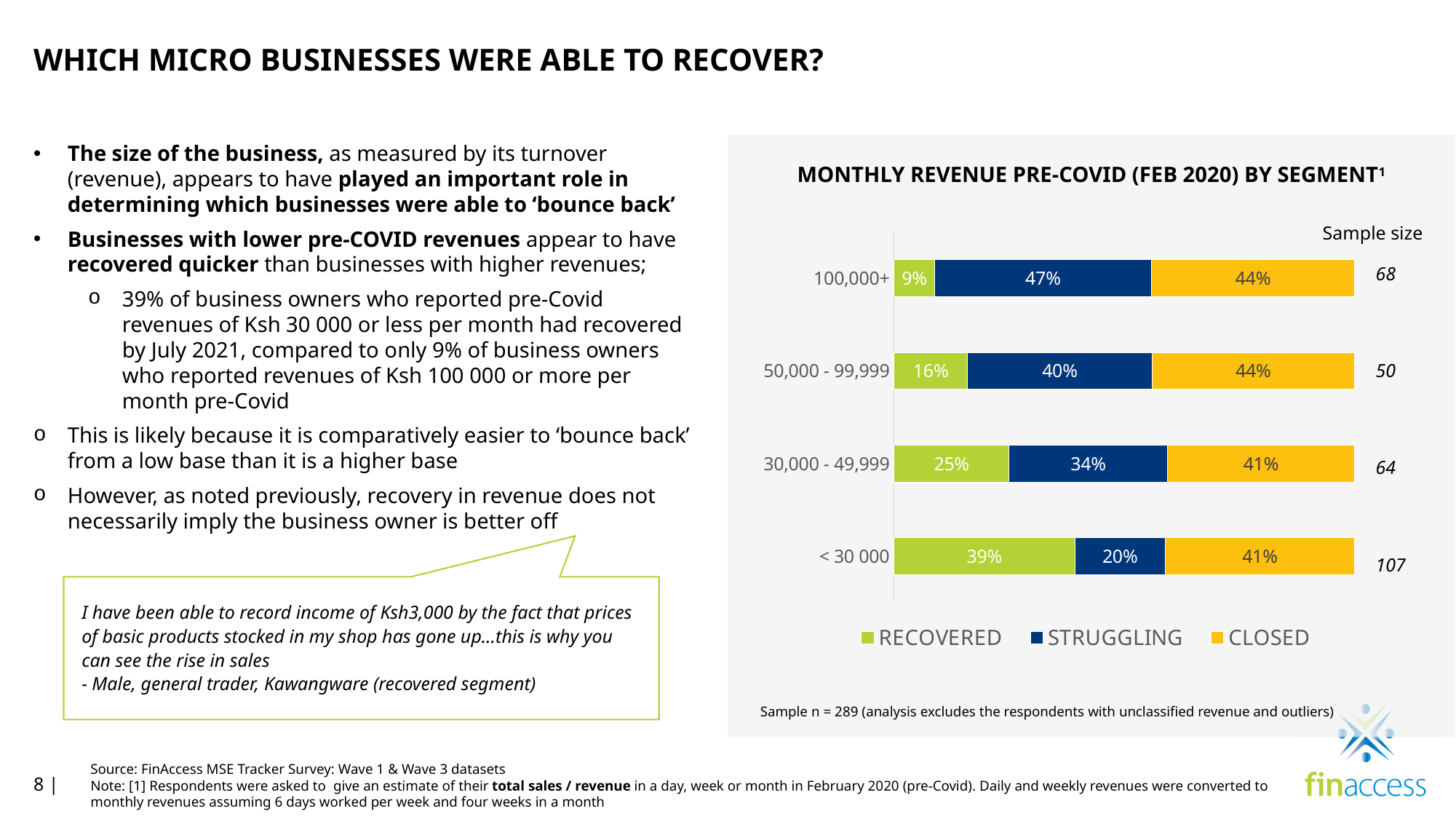
Which colour represents the CLOSED series in the chart? Yellow What percentage of businesses with pre-COVID monthly revenue of 100,000+ had recovered? 9% What percentage of businesses in the 30,000 - 49,999 segment had closed? 41% What kind of chart is shown on the slide? Stacked bar chart What percentage of businesses in the < 30 000 revenue segment were struggling? 20% Which is larger: the struggling share for 100,000+ or the struggling share for 50,000 - 99,999? 100,000+ How many series does the legend list? 3 Which revenue segment has the lowest share of struggling businesses? < 30 000 What is the difference in the recovered share between the < 30 000 segment and the 100,000+ segment? 30 percentage points What is the sample size for the 50,000 - 99,999 revenue segment? 50 How many revenue segments are shown in the chart? 4 Which revenue segment has the highest share of recovered businesses? < 30 000